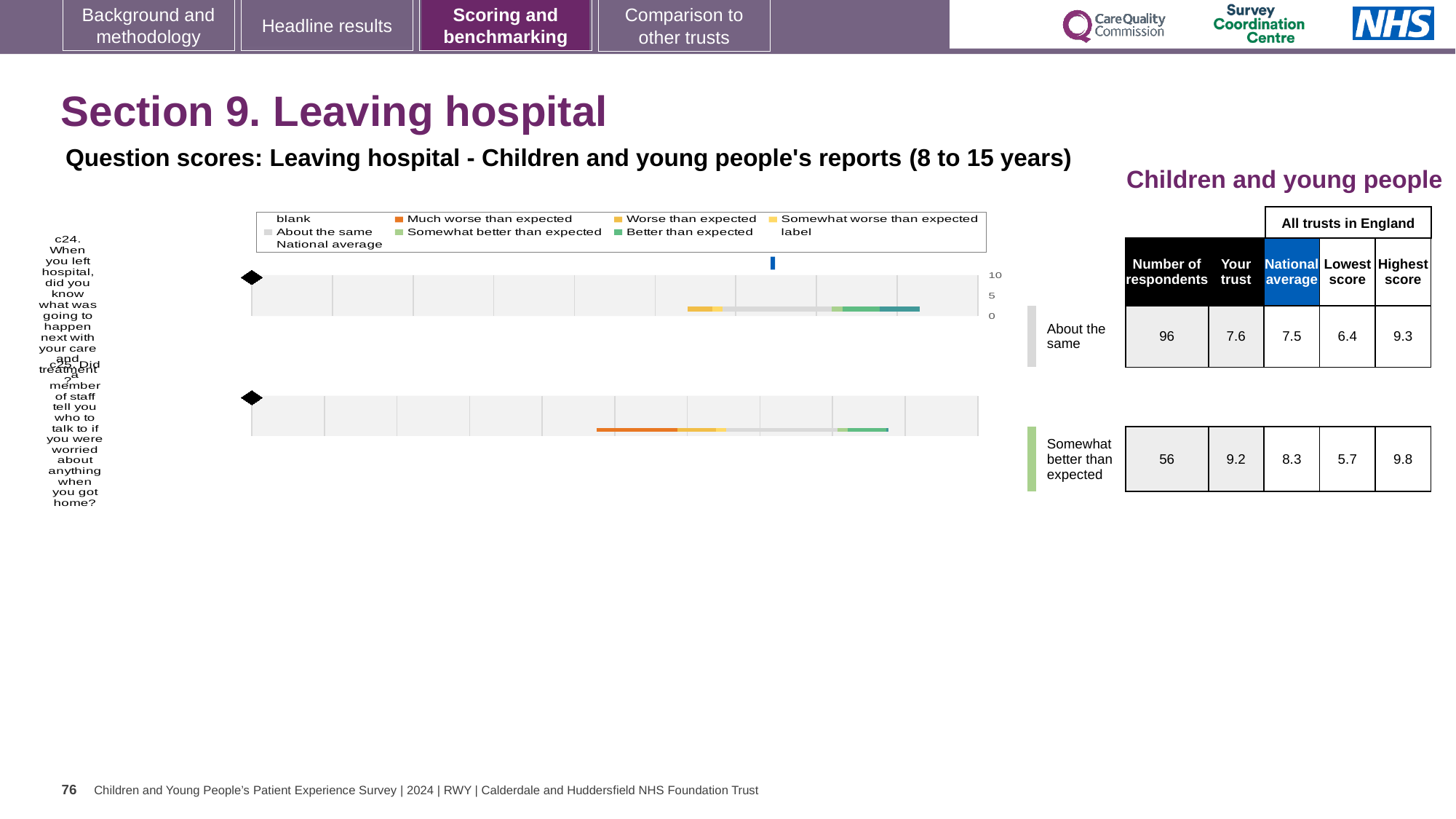
Which survey question is plotted in the top bar of the chart? c24 What kind of chart is shown on the slide? bar chart How many survey questions (bars) are plotted in the chart? 2 How many respondents answered question c25? 56 What is the national average score for question c25 (Did a member of staff tell you who to talk to if you were worried about anything when you got home?)? 8.3 Which question has the higher 'Your trust' score, c24 or c25? c25 For question c25, which is larger: the 'Your trust' score or the national average? Your trust What is the lowest score among all trusts in England for question c24? 6.4 What is the highest tick value shown on the chart's score axis? 10 What is the 'Your trust' score for question c24 (When you left hospital, did you know what was going to happen next with your care and treatment?)? 7.6 Which benchmark category is question c25 placed in? Somewhat better than expected What is the difference between the highest score and the lowest score for question c24? 2.9